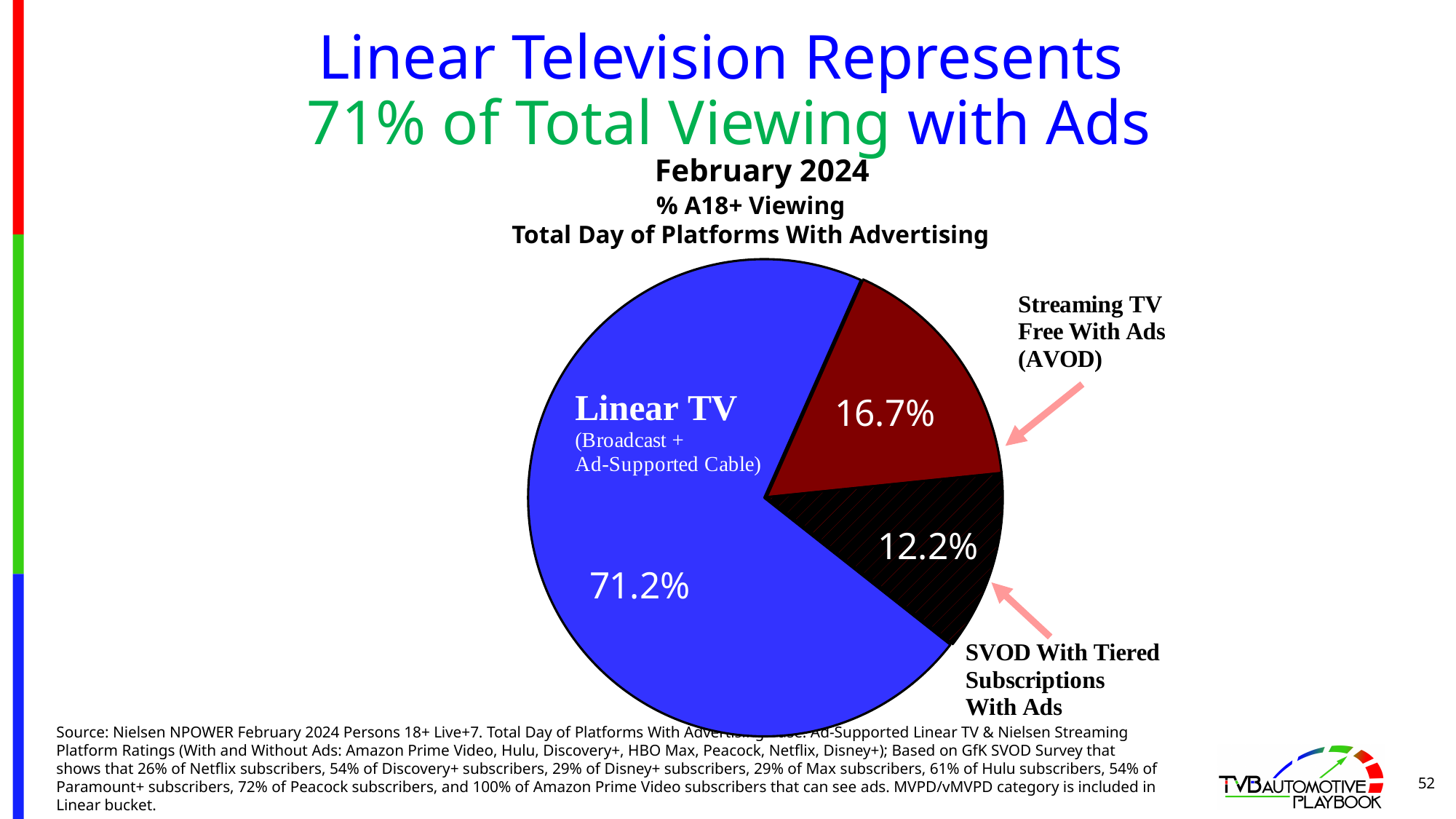
Which slice of the pie chart is the smallest? SVOD With Tiered Subscriptions With Ads What share of viewing does Linear TV represent in the pie chart? 71.2% Which is larger: the share for Streaming TV Free With Ads (AVOD) or the share for SVOD With Tiered Subscriptions With Ads? Streaming TV Free With Ads (AVOD) What share of viewing does SVOD With Tiered Subscriptions With Ads represent? 12.2% How many slices does the pie chart have? 3 What is the difference between the AVOD share and the SVOD With Tiered Subscriptions With Ads share? 4.5% What share of viewing does Streaming TV Free With Ads (AVOD) represent? 16.7% What month and year does the pie chart cover? February 2024 What is the difference between the Linear TV share and the AVOD share? 54.5% What colour is the Linear TV slice of the pie chart? Blue What kind of chart is shown on the slide? Pie chart Which slice of the pie chart is the largest? Linear TV